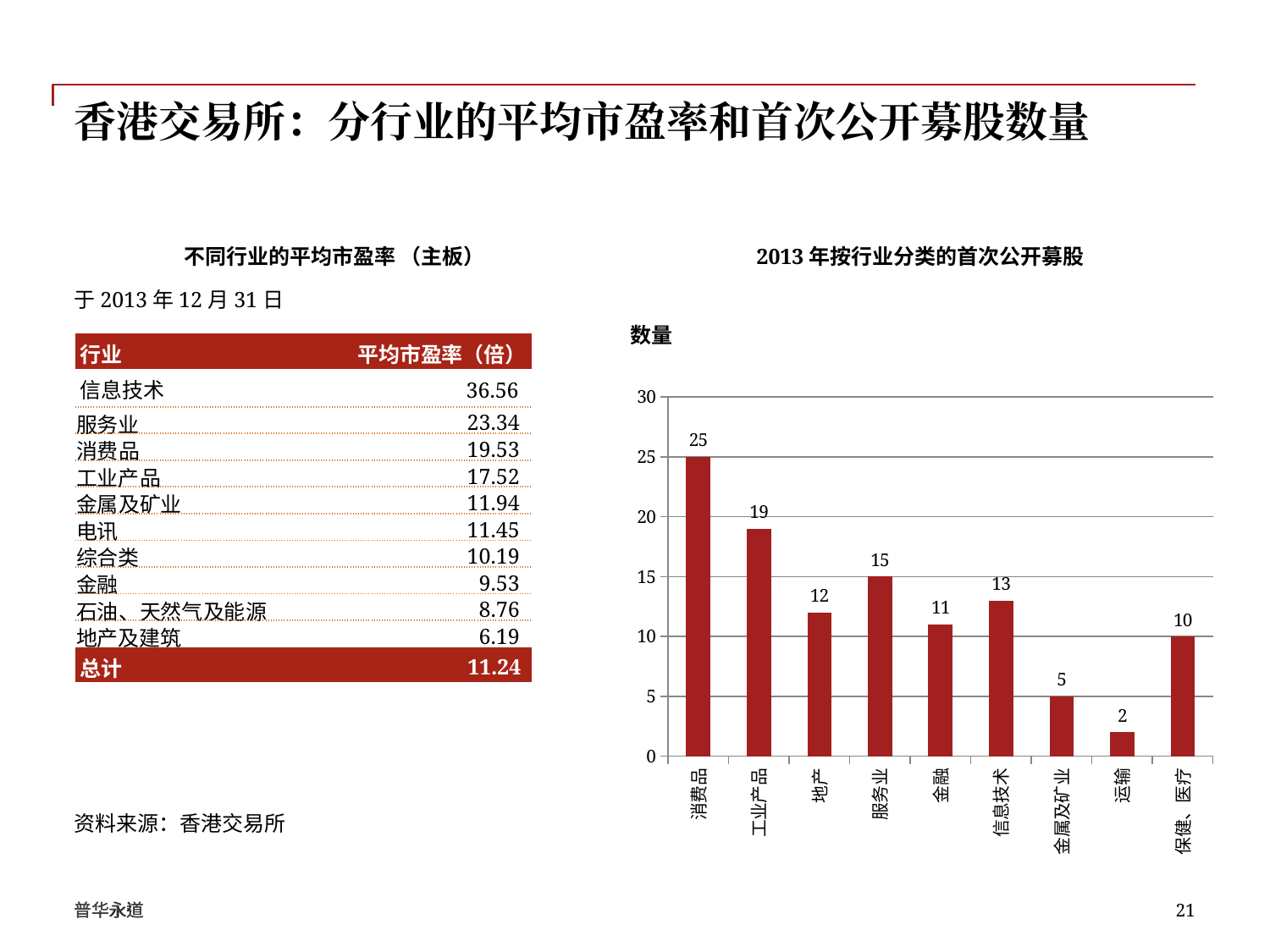
How many industry categories are shown in the chart? 9 What is the difference between the values for 消费品 and 工业产品? 6 Is the value for 金属及矿业 greater or less than 10? less What type of chart is shown on the slide? bar chart What is the label of the vertical axis of the chart? 数量 What is the value for 保健、医疗 in the chart? 10 Which industry has the highest number of IPOs in the chart? 消费品 Which industry has the lowest number of IPOs in the chart? 运输 Which has a larger value in the chart, 服务业 or 信息技术? 服务业 What is the title of the chart on the slide? 2013 年按行业分类的首次公开募股 What is the value for 工业产品 in the chart? 19 How many IPOs does the chart show for 消费品? 25